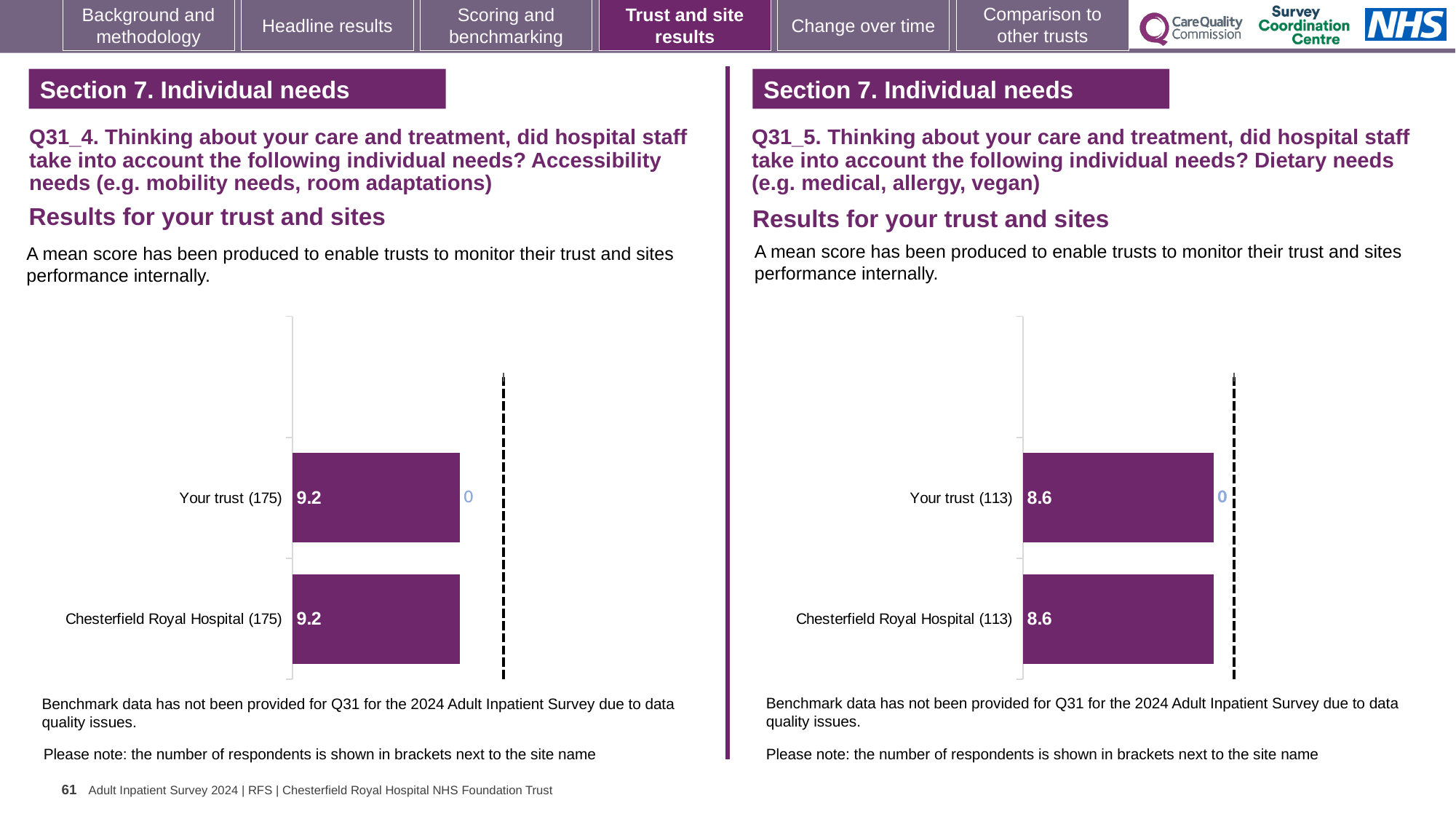
What type of chart is used on the left side of the slide (Q31_4)? Bar chart In the left chart (Q31_4, accessibility needs), what is the mean score for Your trust? 9.2 In the right chart (Q31_5), what is the difference between the scores for Your trust and Chesterfield Royal Hospital? 0.0 In the left chart (Q31_4), what is the difference between the scores for Your trust and Chesterfield Royal Hospital? 0.0 How many bars are shown in the left chart (Q31_4)? 2 How many bars are shown in the right chart (Q31_5)? 2 In the left chart (Q31_4), how many respondents are shown in brackets for Your trust? 175 In the right chart (Q31_5, dietary needs), what is the mean score for Your trust? 8.6 In the right chart (Q31_5, dietary needs), what is the mean score for Chesterfield Royal Hospital? 8.6 In the right chart (Q31_5), how many respondents are shown in brackets for Chesterfield Royal Hospital? 113 In the left chart (Q31_4, accessibility needs), what is the mean score for Chesterfield Royal Hospital? 9.2